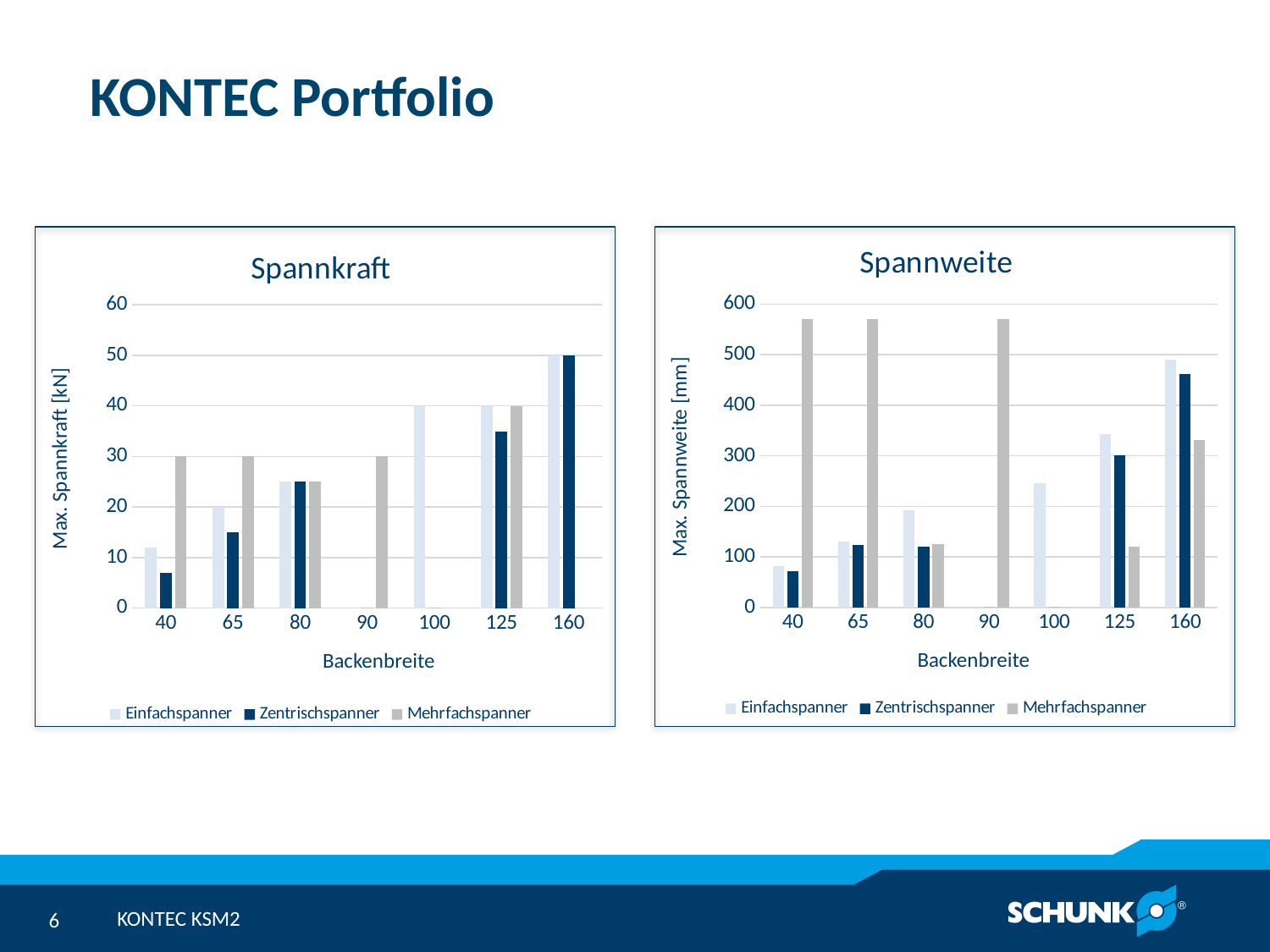
In the Spannkraft chart, at which Backenbreite is the Einfachspanner value highest? 160 In the Spannkraft chart, what is the value for Zentrischspanner at Backenbreite 160? 50 What type of chart is the Spannkraft chart? bar chart In the Spannkraft chart, what is the value for Mehrfachspanner at Backenbreite 40? 30 What is the y-axis label of the Spannweite chart? Max. Spannweite [mm] In the Spannweite chart, at Backenbreite 80, which is larger: Einfachspanner or Zentrischspanner? Einfachspanner In the Spannweite chart, is the value for Mehrfachspanner at Backenbreite 40 greater or less than 500? greater How many Backenbreite categories are shown on the x axis of the Spannkraft chart? 7 In the Spannweite chart, is the value for Einfachspanner at Backenbreite 100 greater or less than 200? greater In the Spannkraft chart, what is the value for Einfachspanner at Backenbreite 100? 40 How many series does the legend of the Spannweite chart list? 3